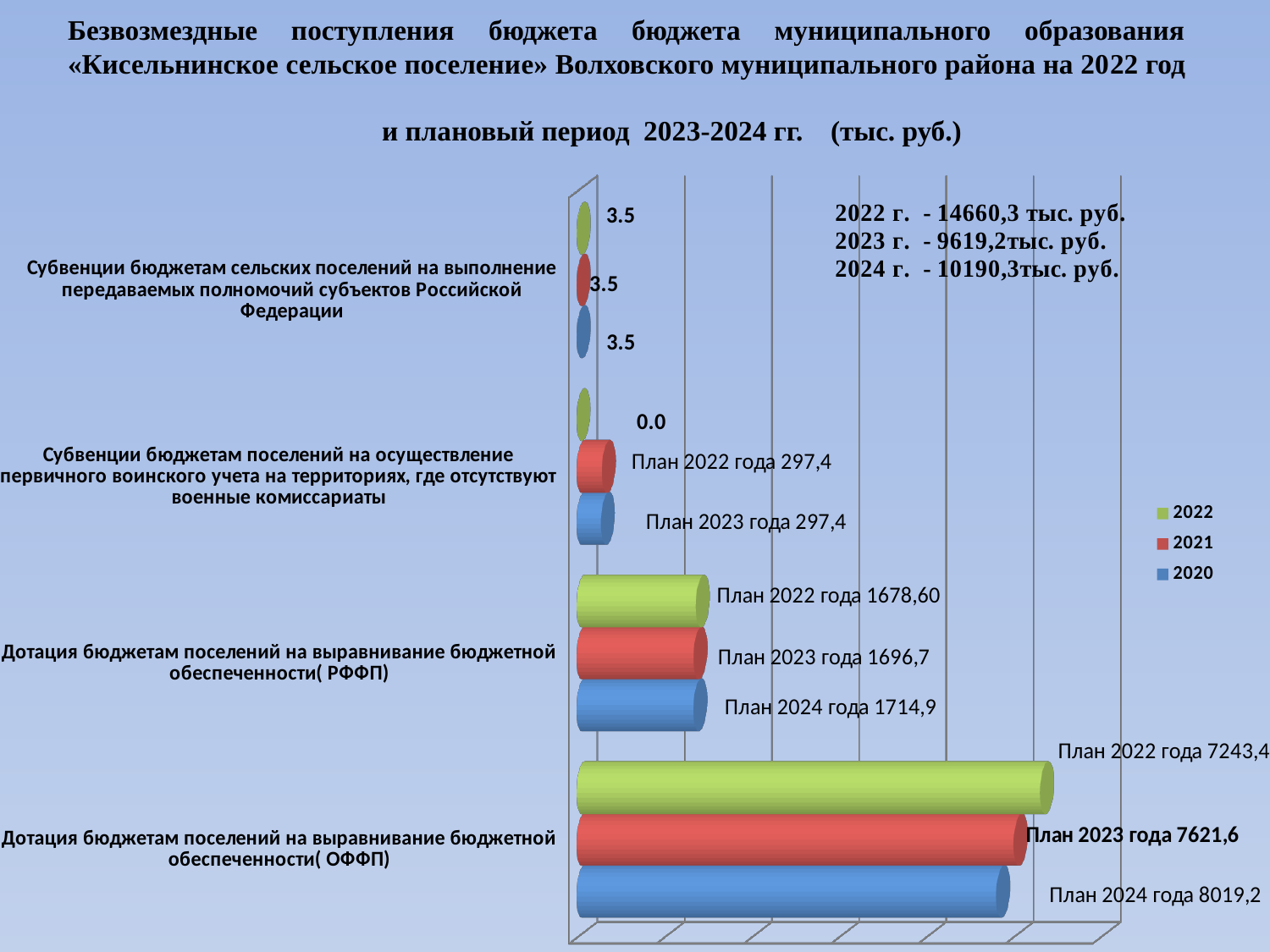
What is the value labelled 'План 2024 года' for 'Дотация бюджетам поселений на выравнивание бюджетной обеспеченности (ОФФП)'? 8019,2 What is the value of the blue bar for 'Субвенции бюджетам сельских поселений на выполнение передаваемых полномочий субъектов Российской Федерации'? 3.5 For the ОФФП category, which is larger: the 'План 2023 года' value or the 'План 2022 года' value? План 2023 года Which category has the largest bars on the chart? Дотация бюджетам поселений на выравнивание бюджетной обеспеченности (ОФФП) What is the value labelled 'План 2023 года' for 'Дотация бюджетам поселений на выравнивание бюджетной обеспеченности (РФФП)'? 1696,7 What are the legend entries of the chart? 2022, 2021, 2020 What is the value of the green bar for 'Субвенции бюджетам поселений на осуществление первичного воинского учета'? 0.0 What kind of chart is shown on the slide? bar chart What is the value labelled 'План 2022 года' for 'Дотация бюджетам поселений на выравнивание бюджетной обеспеченности (ОФФП)'? 7243,4 For the ОФФП category, what is the difference between the 'План 2024 года' value and the 'План 2022 года' value? 775,8 How many series does the legend list? 3 How many categories are plotted on the chart? 4